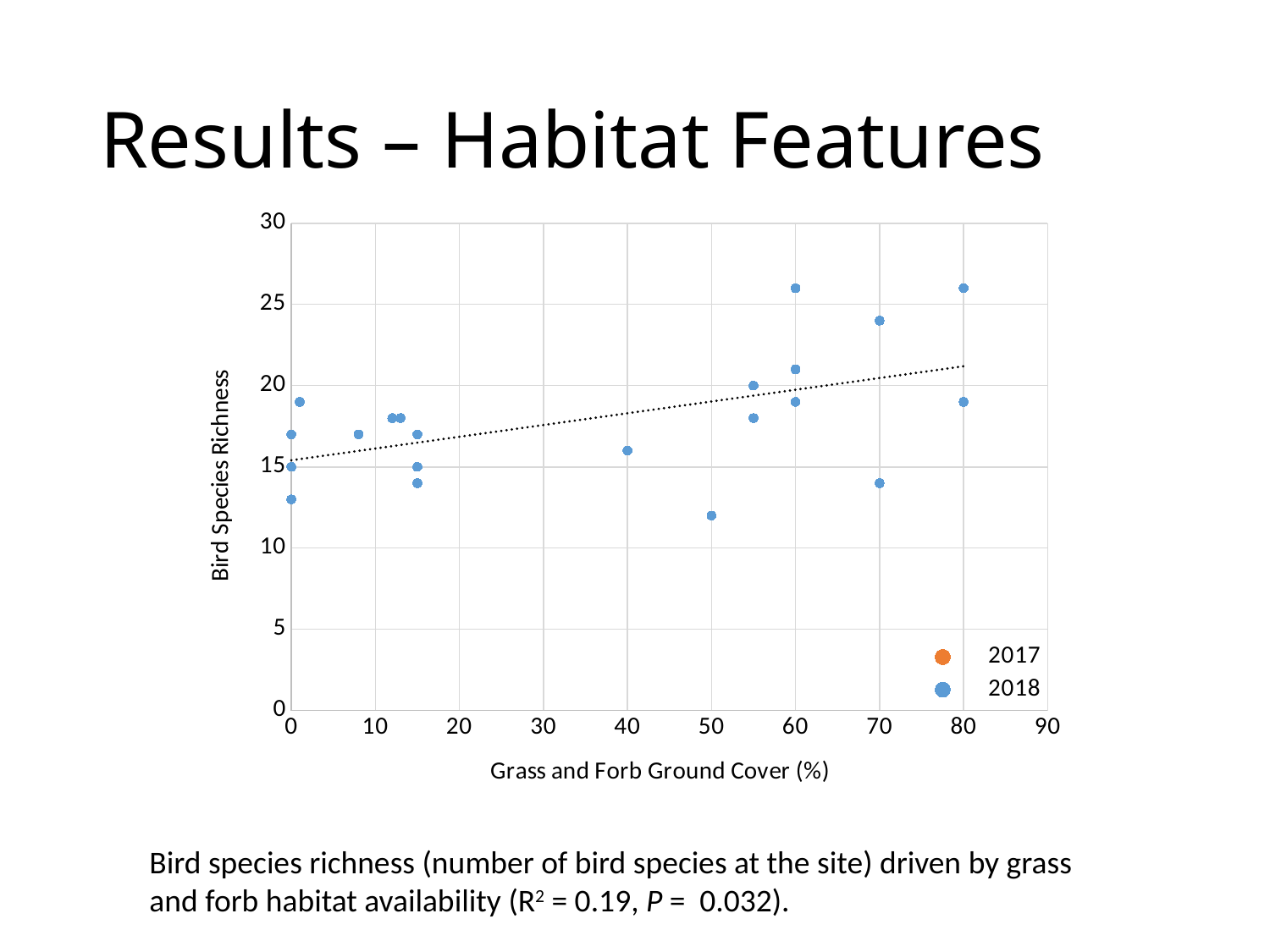
How many series does the legend list? 2 What kind of chart is shown on the slide? scatter chart Is the highest bird species richness plotted at 70% grass and forb ground cover greater or less than 20? greater Is the bird species richness at 50% grass and forb ground cover greater or less than 15? less What is the title of the y axis? Bird Species Richness What is the title of the x axis? Grass and Forb Ground Cover (%) Which is larger: the bird species richness at 40% ground cover or at 50% ground cover? 40% ground cover Is the highest bird species richness plotted at 60% grass and forb ground cover greater or less than 25? greater Does bird species richness generally rise or fall as grass and forb ground cover increases, according to the trend line? rise